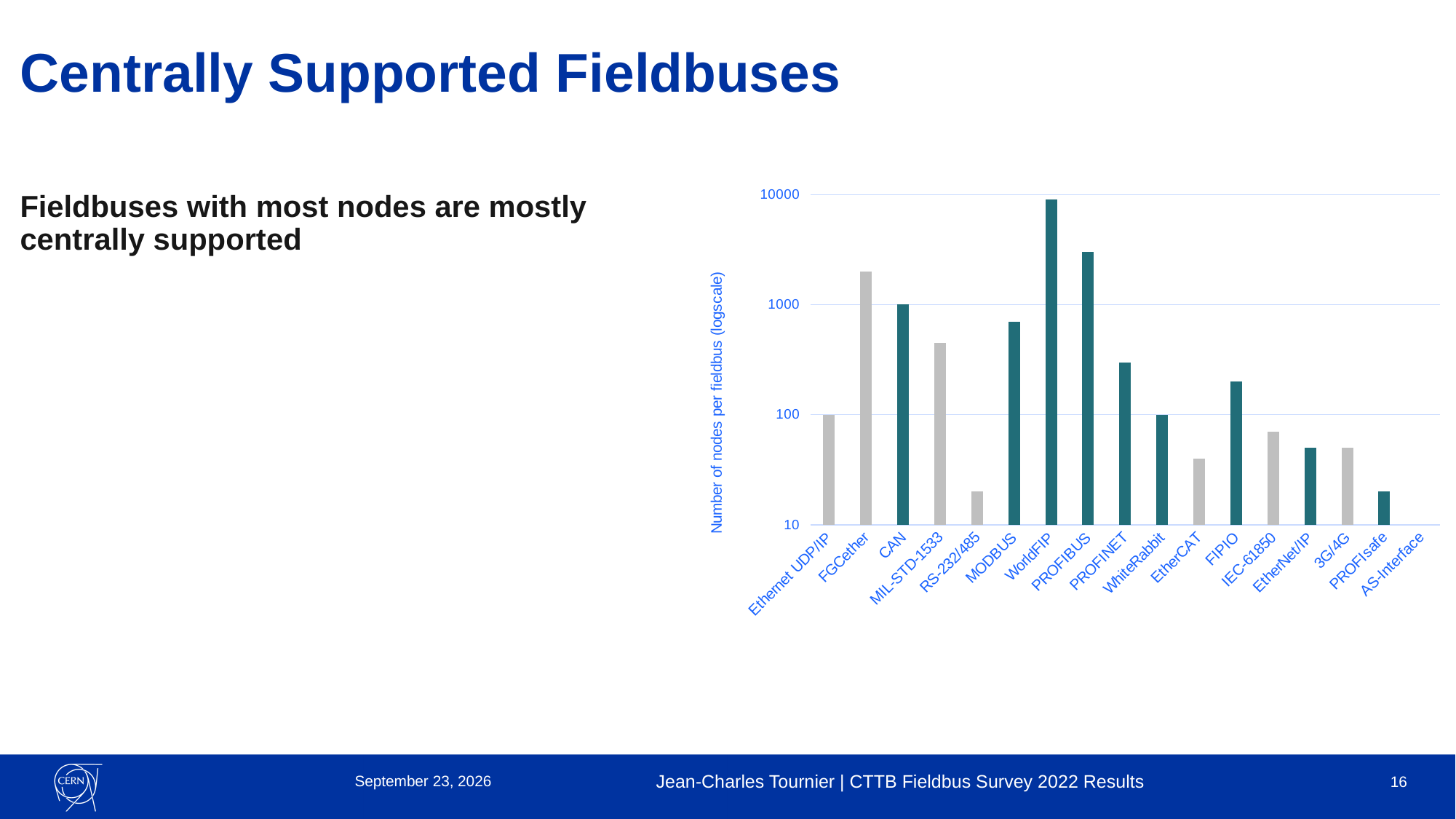
What is the label of the y axis? Number of nodes per fieldbus (logscale) Is the value for MODBUS greater or less than 1000? less What is the number of nodes for CAN? 1000 Is the value for EtherCAT greater or less than 100? less How many fieldbus categories are listed on the x axis? 17 What is the number of nodes for Ethernet UDP/IP? 100 What kind of chart is shown on the slide? bar chart Which has more nodes, WorldFIP or PROFIBUS? WorldFIP Which fieldbus has the highest number of nodes? WorldFIP Is the value for FIPIO greater or less than 100? greater What is the number of nodes for WhiteRabbit? 100